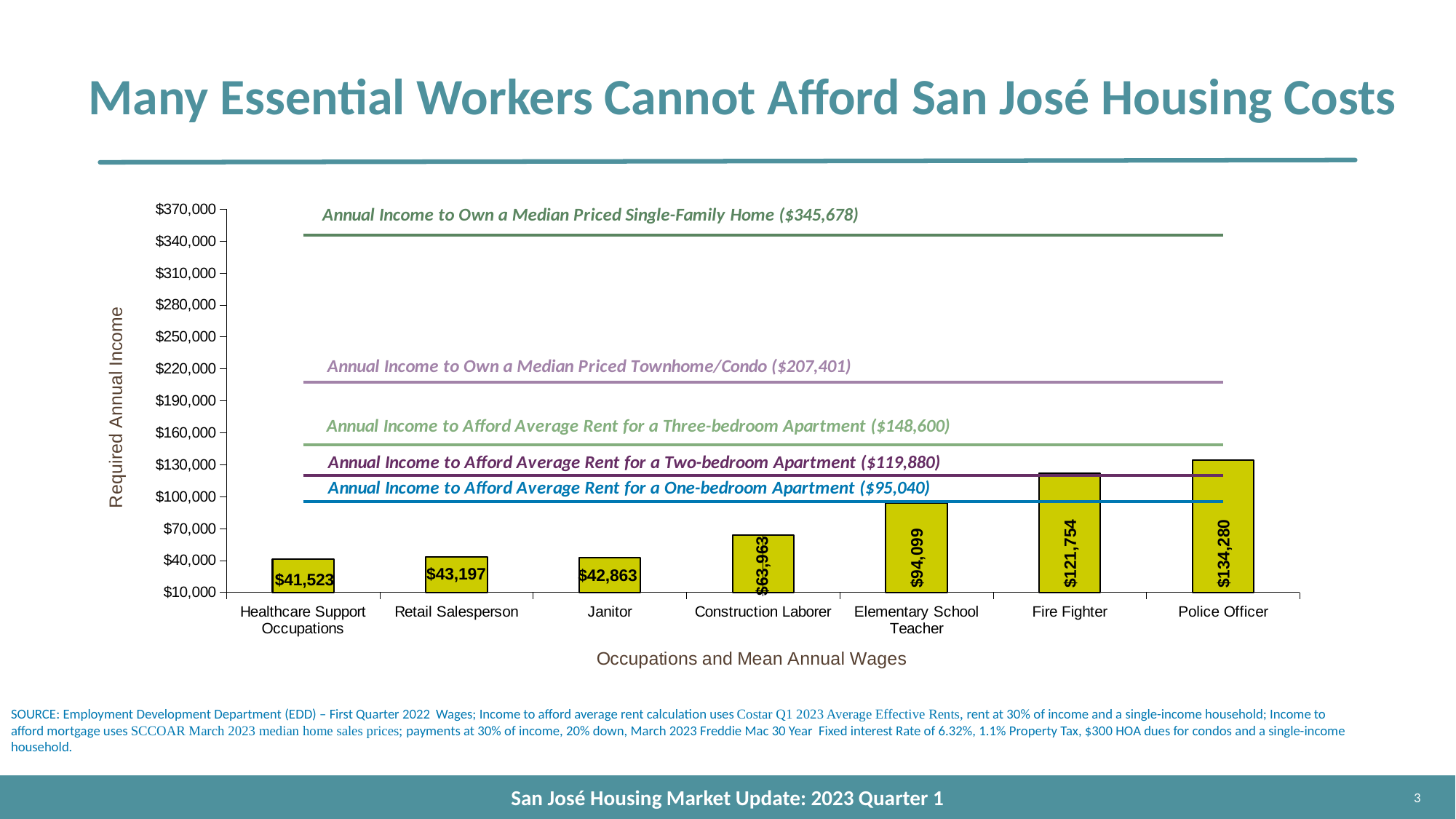
Is the mean annual wage for Fire Fighter greater or less than $100,000? greater Which occupation has the highest mean annual wage on the chart? Police Officer How many occupations are shown on the chart? 7 What is the mean annual wage shown for Elementary School Teacher? $94,099 What is the difference between the mean annual wages of Police Officer and Fire Fighter? $12,526 What is the mean annual wage shown for Construction Laborer? $63,963 What is the mean annual wage shown for Healthcare Support Occupations? $41,523 According to the reference line on the chart, what annual income is needed to own a median priced single-family home? $345,678 What kind of chart is used to show the occupations' mean annual wages? bar chart Which occupation has the lowest mean annual wage on the chart? Healthcare Support Occupations What is the mean annual wage shown for Police Officer? $134,280 Which has the larger mean annual wage, Retail Salesperson or Janitor? Retail Salesperson